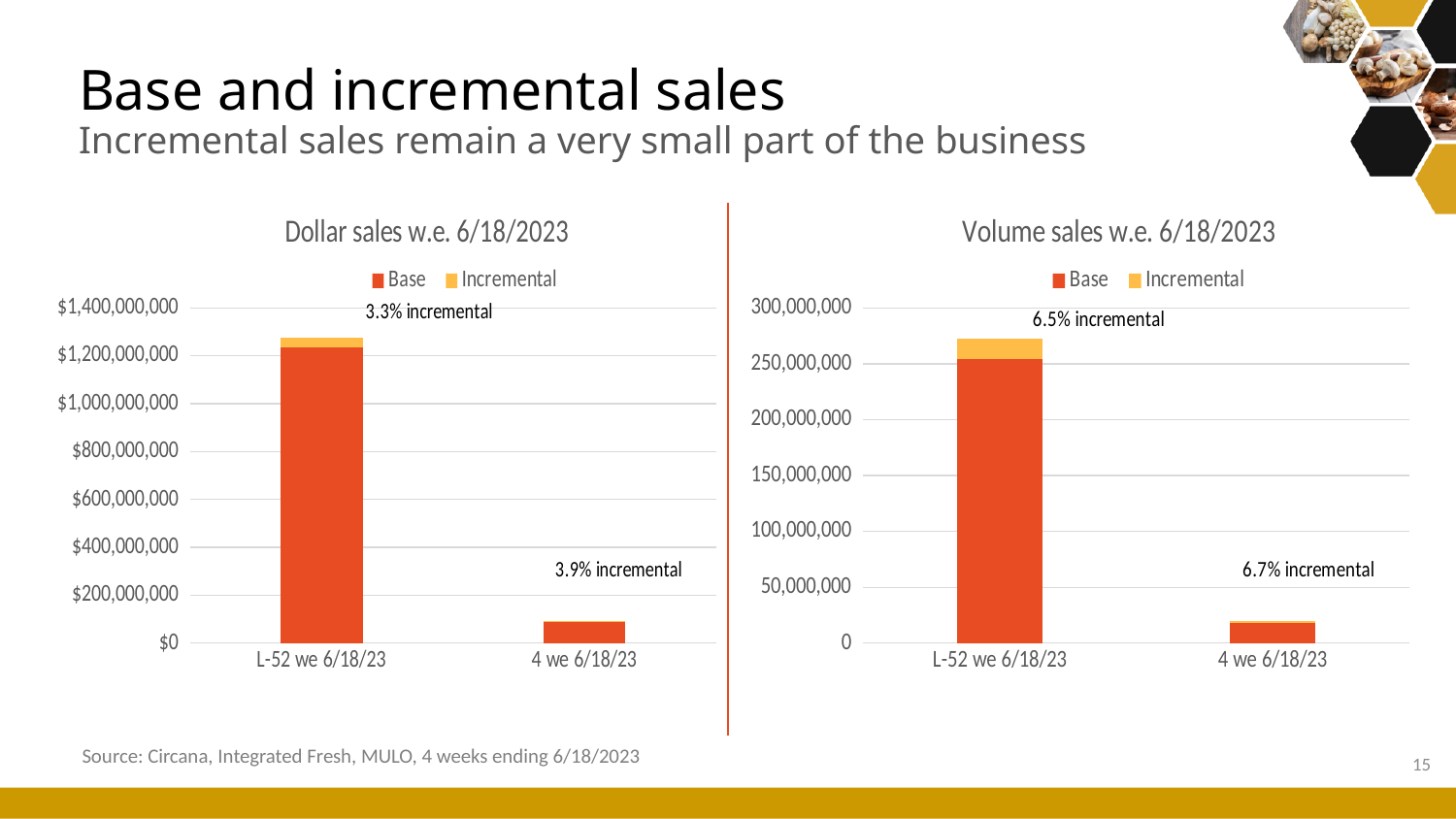
How many series does the legend of the "Volume sales w.e. 6/18/2023" chart list? 2 In the "Dollar sales w.e. 6/18/2023" chart, which period has the taller stacked bar? L-52 we 6/18/23 In the "Volume sales w.e. 6/18/2023" chart, what incremental percentage is labelled for 4 we 6/18/23? 6.7% incremental In the "Dollar sales w.e. 6/18/2023" chart, is the total stacked bar for L-52 we 6/18/23 greater or less than $1,000,000,000? greater In the "Dollar sales w.e. 6/18/2023" chart, what incremental percentage is labelled for L-52 we 6/18/23? 3.3% incremental In the "Dollar sales w.e. 6/18/2023" chart, what incremental percentage is labelled for 4 we 6/18/23? 3.9% incremental In the "Dollar sales w.e. 6/18/2023" chart, is the total stacked bar for 4 we 6/18/23 greater or less than $200,000,000? less In the "Volume sales w.e. 6/18/2023" chart, is the total stacked bar for L-52 we 6/18/23 greater or less than 200,000,000? greater What are the two legend entries in the "Volume sales w.e. 6/18/2023" chart? Base and Incremental What kind of chart is the "Dollar sales w.e. 6/18/2023" chart? Stacked bar chart In the "Volume sales w.e. 6/18/2023" chart, what incremental percentage is labelled for L-52 we 6/18/23? 6.5% incremental How many categories are shown on the x axis of the "Dollar sales w.e. 6/18/2023" chart? 2